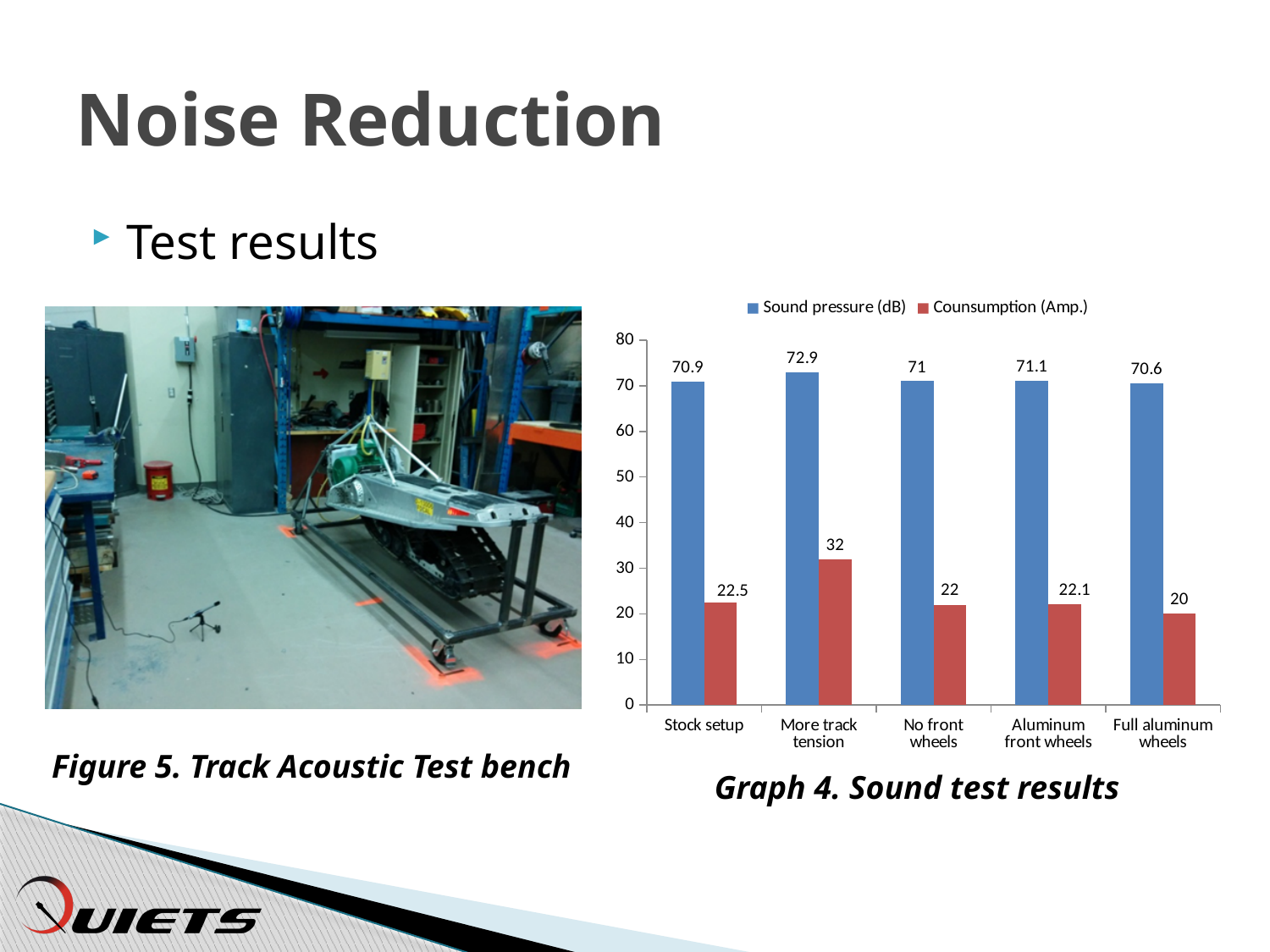
What is the Sound pressure (dB) value for Full aluminum wheels? 70.6 How many series does the legend list? 2 What is the difference in Counsumption (Amp.) between More track tension and Stock setup? 9.5 What is the Sound pressure (dB) value for Stock setup? 70.9 What is the caption of the chart on the slide? Graph 4. Sound test results How many categories are shown on the x axis of the chart? 5 Which category has the highest Sound pressure (dB)? More track tension What kind of chart is Graph 4? Bar chart Is the Counsumption (Amp.) value for More track tension greater or less than 30? greater Which has a higher Sound pressure (dB): More track tension or No front wheels? More track tension Which category has the lowest Counsumption (Amp.)? Full aluminum wheels What is the Counsumption (Amp.) value for More track tension? 32